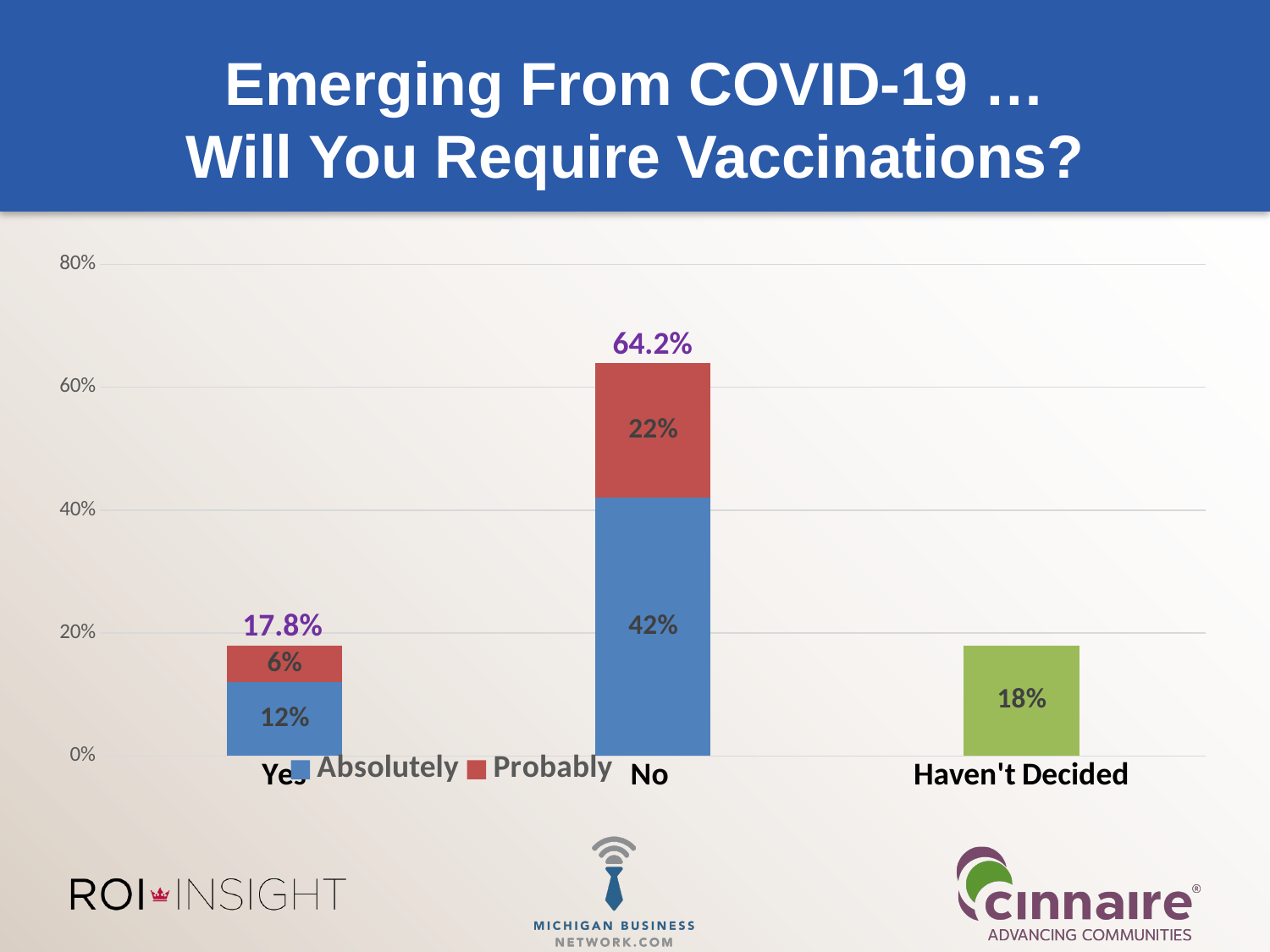
What is the Absolutely value for the Yes category? 12% Which is larger, the Probably value for No or the Absolutely value for Yes? Probably value for No What is the Probably value for the No category? 22% Which category has the tallest bar? No What value is shown for the Haven't Decided category? 18% What is the Probably value for the Yes category? 6% What is the difference between the Absolutely values for No and Yes? 30% What kind of chart is shown on the slide? stacked bar chart What is the total labelled above the No bar? 64.2% How many series does the legend list? 2 What is the total labelled above the Yes bar? 17.8% What is the Absolutely value for the No category? 42%